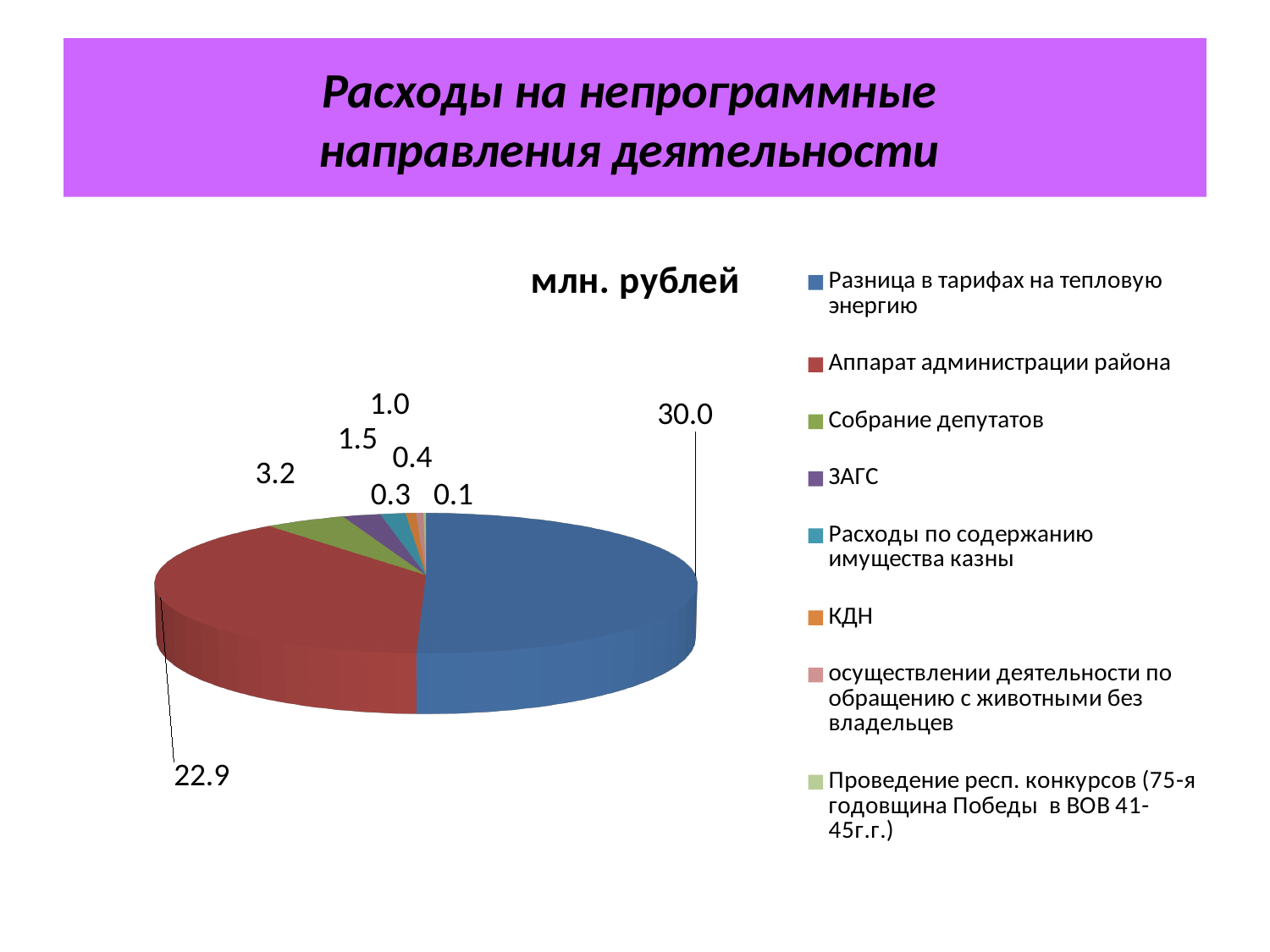
What is the value for Разница в тарифах на тепловую энергию? 30.0 Which category has the largest slice of the pie? Разница в тарифах на тепловую энергию How many categories does the legend of the pie chart list? 8 What is the value for ЗАГС? 1.5 What is the value for Аппарат администрации района? 22.9 What colour is the slice for Аппарат администрации района? red Which is larger: the value for Аппарат администрации района or the value for Собрание депутатов? Аппарат администрации района What is the value for Собрание депутатов? 3.2 What kind of chart is shown on the slide? pie chart What is the title of the chart? млн. рублей What is the difference between the values for Разница в тарифах на тепловую энергию and Аппарат администрации района? 7.1 Which category has the smallest slice of the pie? Проведение респ. конкурсов (75-я годовщина Победы в ВОВ 41-45г.г.)